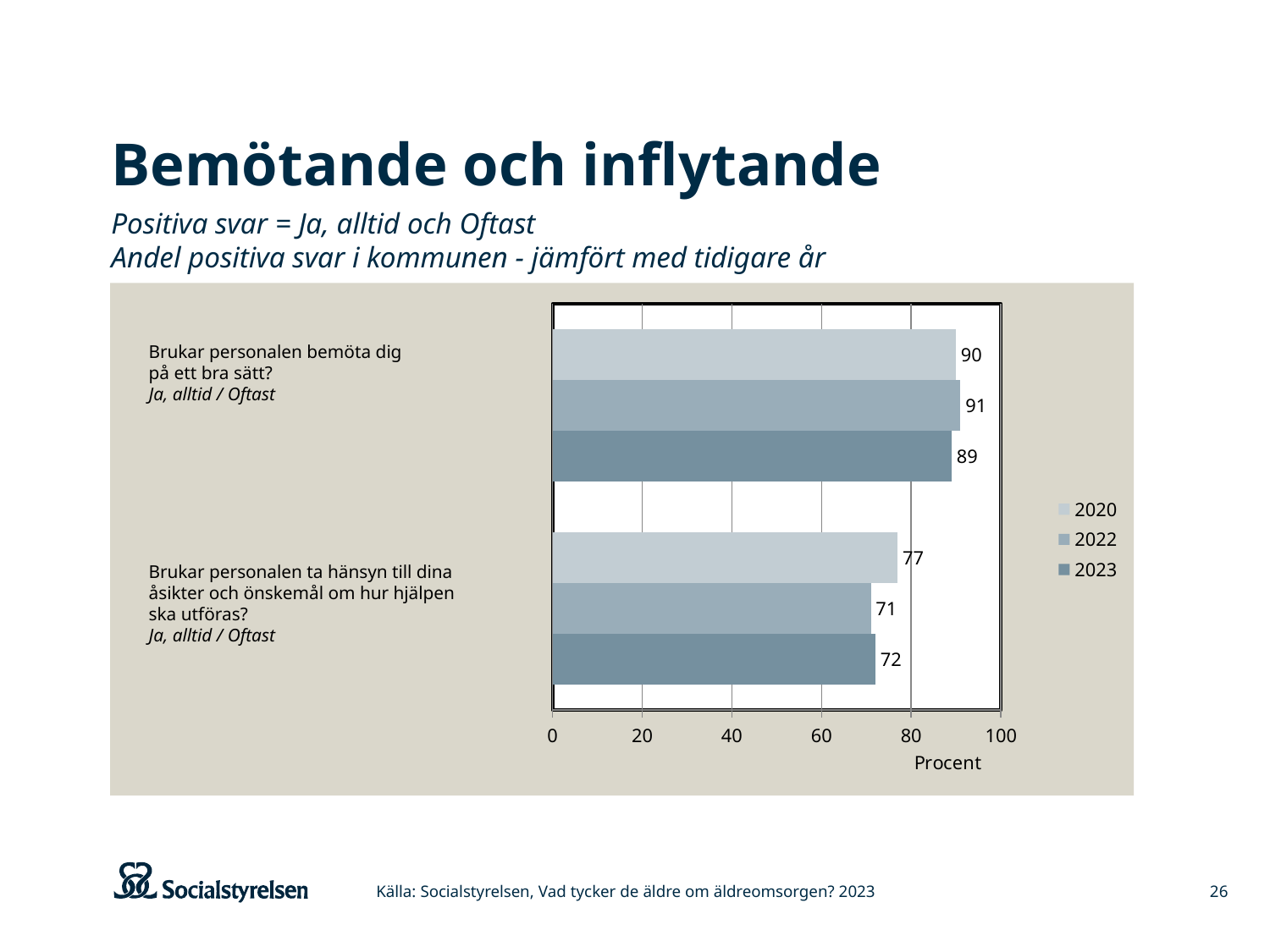
What kind of chart is shown on the slide? bar chart What is the 2023 value for "Brukar personalen bemöta dig på ett bra sätt?" 89 What is the label of the x axis? Procent What is the difference between the 2020 and 2022 values for "Brukar personalen ta hänsyn till dina åsikter och önskemål om hur hjälpen ska utföras?" 6 How many series does the legend list? 3 Which year has the highest value for "Brukar personalen bemöta dig på ett bra sätt?" 2022 What is the 2020 value for "Brukar personalen ta hänsyn till dina åsikter och önskemål om hur hjälpen ska utföras?" 77 Is the 2022 value for "Brukar personalen ta hänsyn till dina åsikter och önskemål om hur hjälpen ska utföras?" greater or less than 80? less How many question categories are shown in the chart? 2 Which is larger: the 2023 value for "Brukar personalen bemöta dig på ett bra sätt?" or the 2023 value for "Brukar personalen ta hänsyn till dina åsikter och önskemål om hur hjälpen ska utföras?" Brukar personalen bemöta dig på ett bra sätt? Which year has the lowest value for "Brukar personalen ta hänsyn till dina åsikter och önskemål om hur hjälpen ska utföras?" 2022 What is the 2022 value for "Brukar personalen bemöta dig på ett bra sätt?" 91